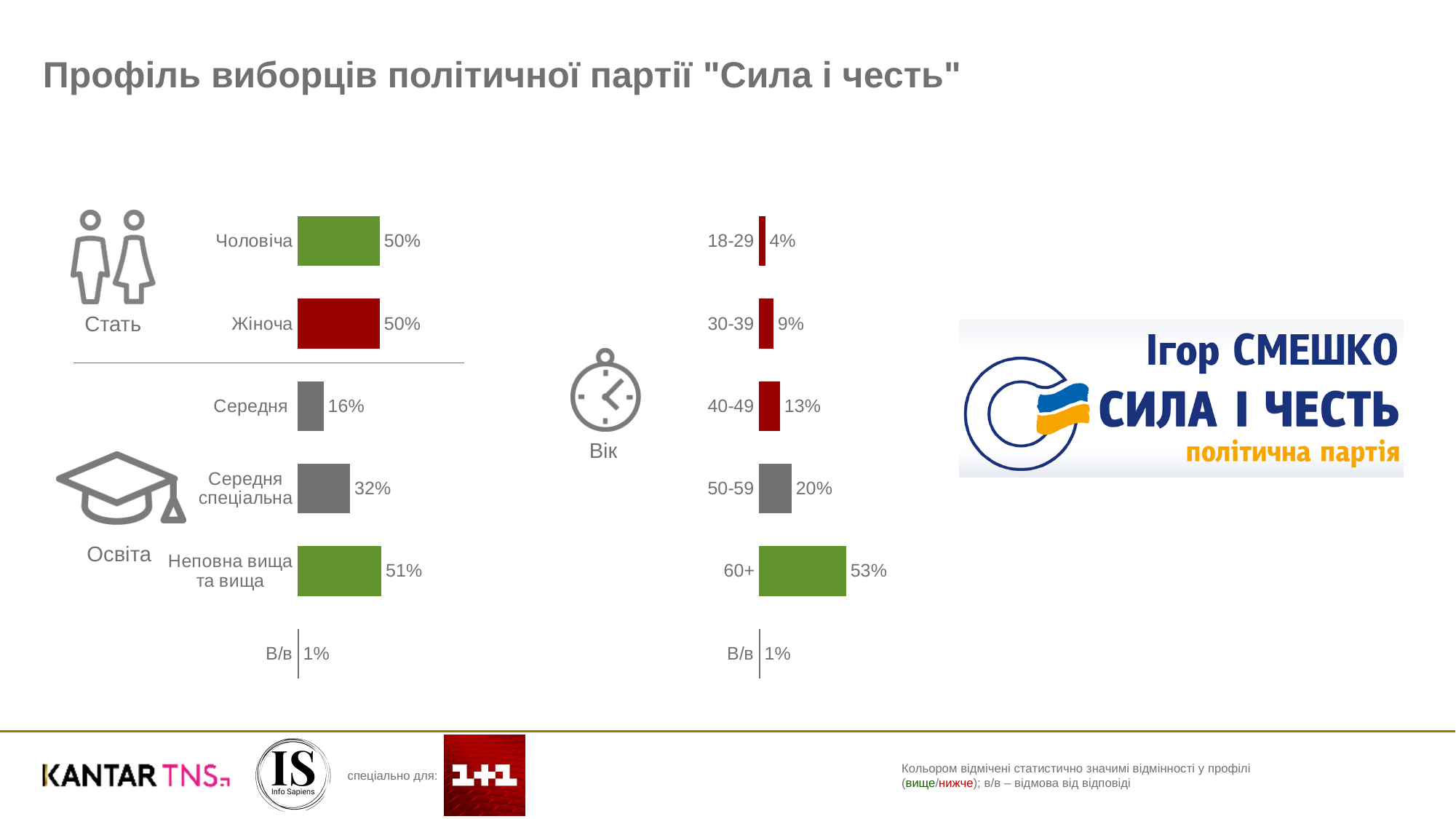
In the Вік chart, how many age categories are shown, including В/в? 6 In the Освіта chart, what is the value for Середня спеціальна? 32% In the Освіта chart, which category has the highest value? Неповна вища та вища In the Вік chart, which age group has the lowest value? 18-29 In the Вік chart, what is the value for 40-49? 13% In the Стать chart, what is the value for Чоловіча? 50% In the Вік chart, which age group has the highest value? 60+ In the Освіта chart, what is the difference between the values for Середня спеціальна and Середня? 16% In the Вік chart, do the values rise or fall from 18-29 to 60+? Rise In the Вік chart, what is the difference between the values for 60+ and 50-59? 33% What kind of chart is the Вік chart? Bar chart In the Вік chart, which is larger, the value for 30-39 or the value for 50-59? 50-59